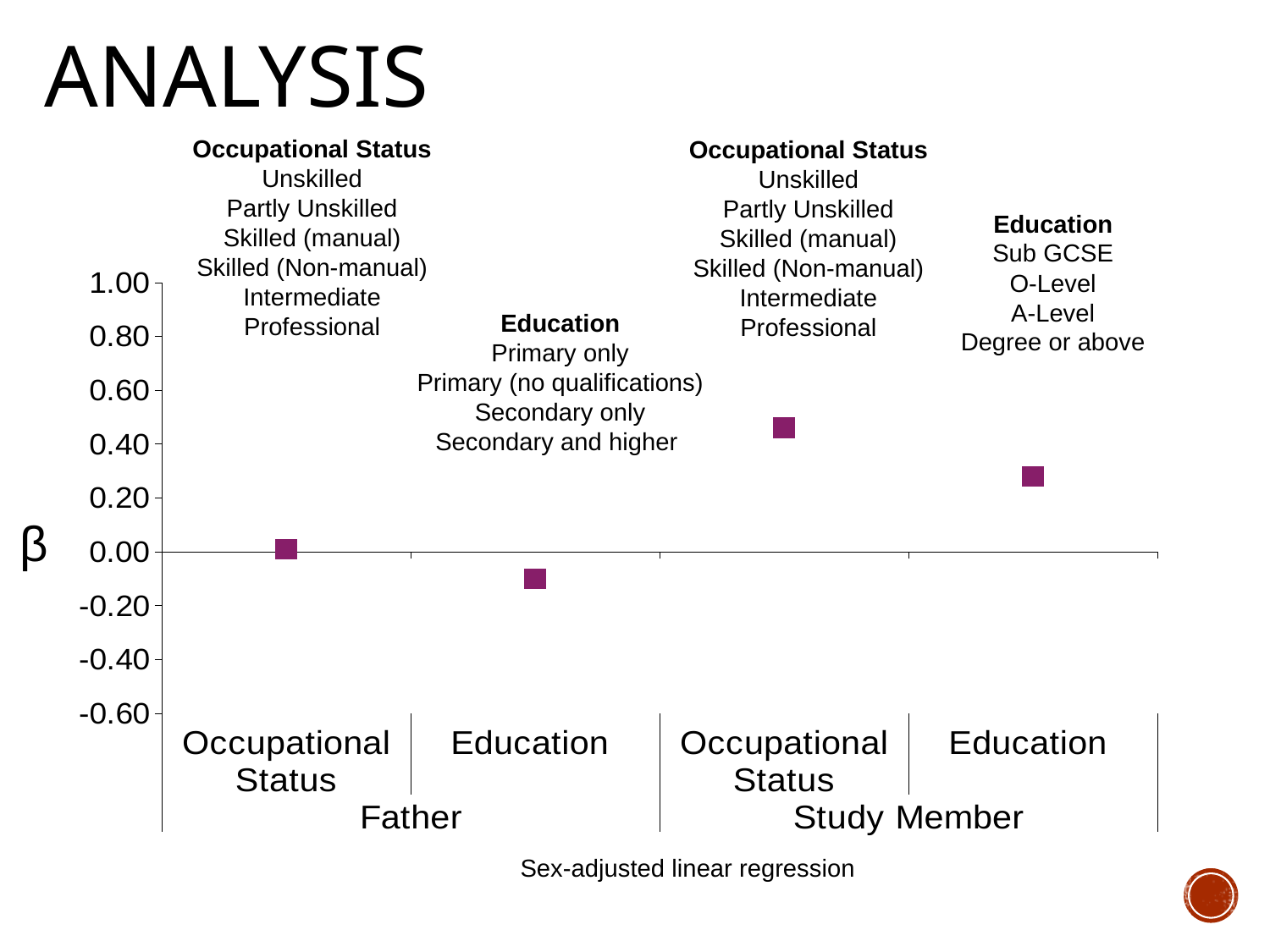
Which is larger, the β value for Father Occupational Status or for Study Member Occupational Status? Study Member Occupational Status Is the β value for Study Member Occupational Status greater or less than 0.40? greater Which category has the lowest β value? Father Education Which is larger, the β value for Father Education or for Study Member Education? Study Member Education How many data points are plotted on the chart? 4 Which category has the highest β value? Study Member Occupational Status Is the β value for Study Member Education greater or less than 0.20? greater Is the β value for Study Member Education greater or less than 0.40? less What is the label on the vertical axis of the chart? β What kind of chart is shown on the slide? scatter chart What note is printed below the chart describing the analysis method? Sex-adjusted linear regression